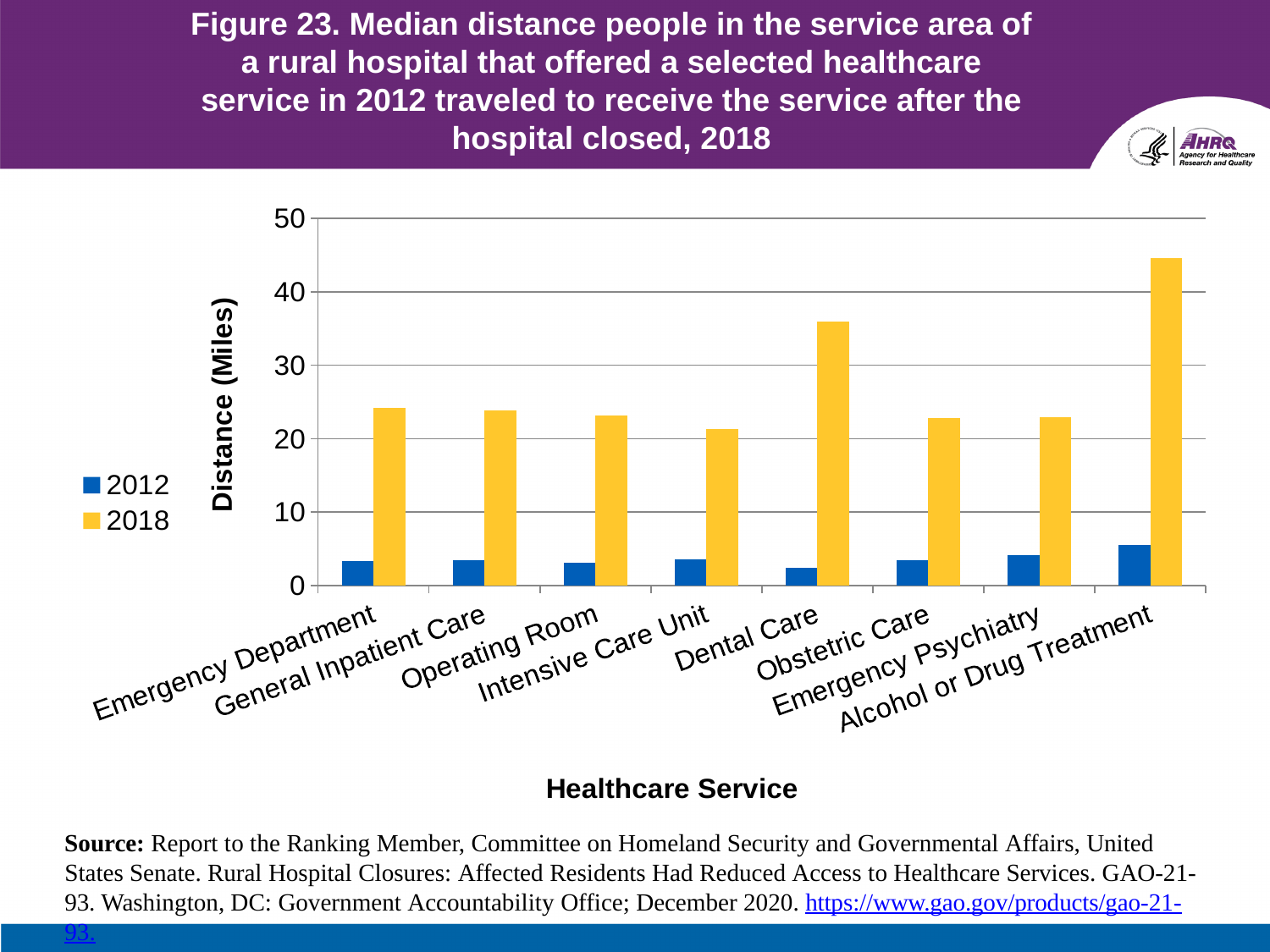
Which healthcare service has the highest 2018 median distance? Alcohol or Drug Treatment What kind of chart is shown on the slide? bar chart Is the 2018 value for Alcohol or Drug Treatment greater or less than 40? greater Is the 2012 value for Operating Room greater or less than 10? less What is the title of the vertical axis? Distance (Miles) Which healthcare service has the highest 2012 median distance? Alcohol or Drug Treatment How many healthcare service categories are shown on the x axis? 8 Is the 2018 value for Emergency Department greater or less than 30? less Which is larger, the 2018 value for Dental Care or the 2018 value for Obstetric Care? Dental Care Which healthcare service has the lowest 2012 median distance? Dental Care How many series does the legend list? 2